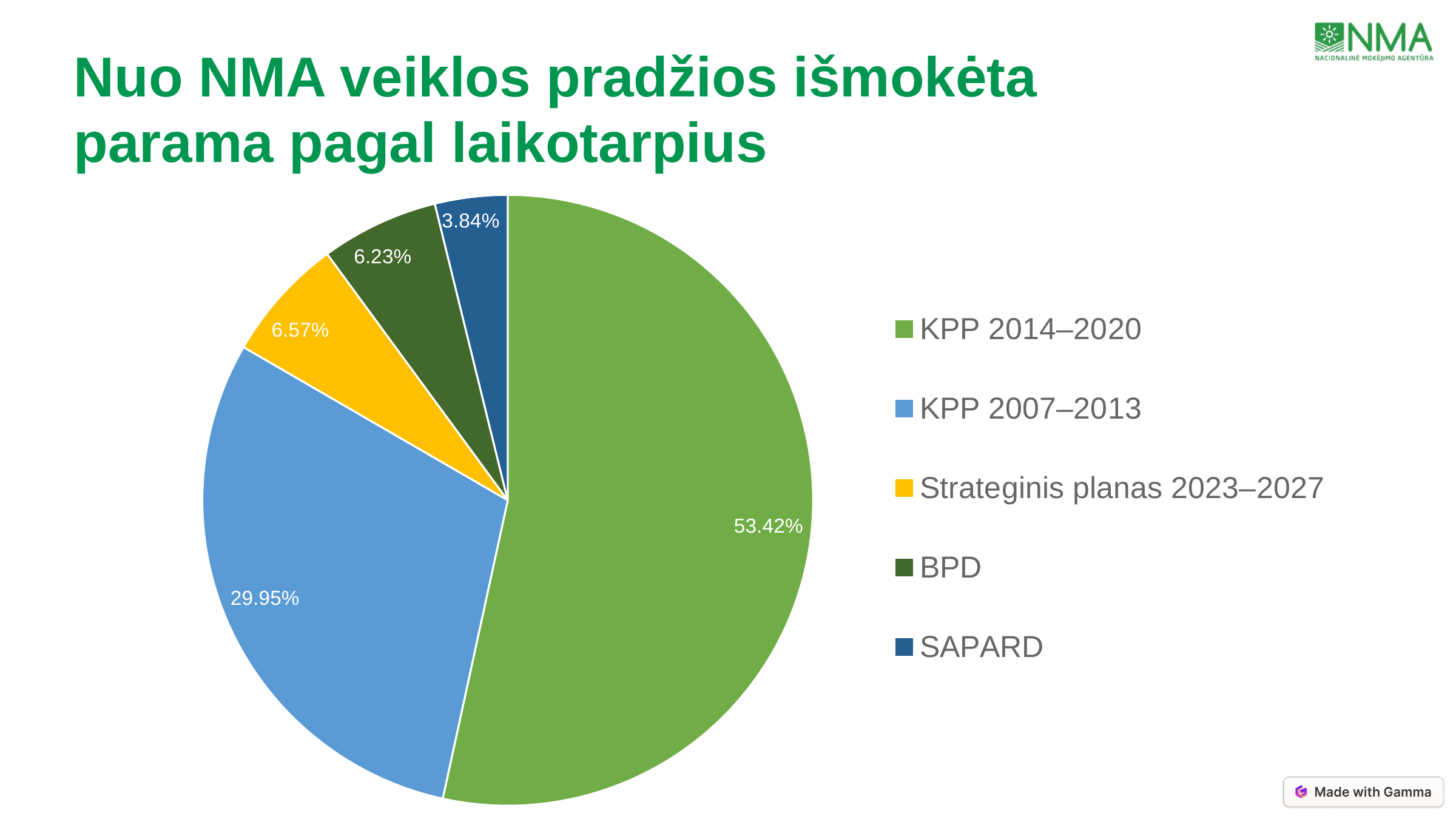
Which category has the largest slice of the pie? KPP 2014–2020 What share of the pie does BPD have? 6.23% How many categories does the legend list? 5 What share of the pie does KPP 2007–2013 have? 29.95% Which is larger, the share for BPD or the share for SAPARD? BPD What share of the pie does SAPARD have? 3.84% What colour is the slice for Strateginis planas 2023–2027? yellow What kind of chart is shown on the slide? pie chart Which category has the smallest slice of the pie? SAPARD What is the difference in percentage points between KPP 2014–2020 and KPP 2007–2013? 23.47